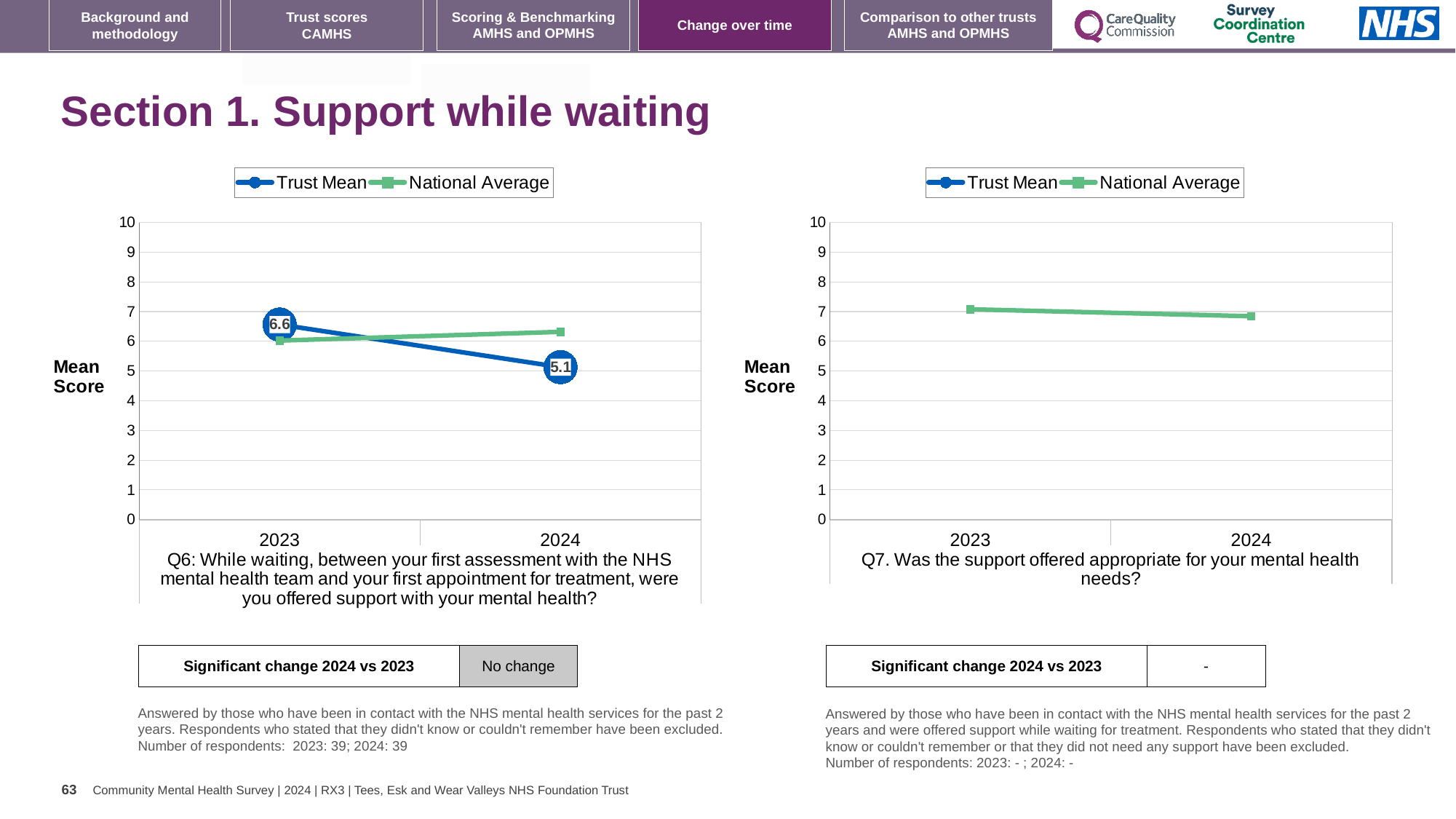
How many years are shown on the x axis of the right chart (Q7)? 2 How many series does the legend of the left chart (Q6) list? 2 In the left chart (Q6), which year has the higher Trust Mean, 2023 or 2024? 2023 In the left chart (Q6), by how much did the Trust Mean fall from 2023 to 2024? 1.5 In the left chart (Q6), is the National Average for 2024 greater or less than 6? greater In the right chart (Q7), is the National Average for 2024 greater or less than 8? less In the left chart (Q6), what is the Trust Mean score for 2024? 5.1 In the left chart (Q6), is the National Average for 2023 greater or less than 7? less What type of chart is the left chart (Q6)? line chart In the left chart (Q6), what is the Trust Mean score for 2023? 6.6 In the left chart (Q6), does the Trust Mean rise or fall from 2023 to 2024? fall